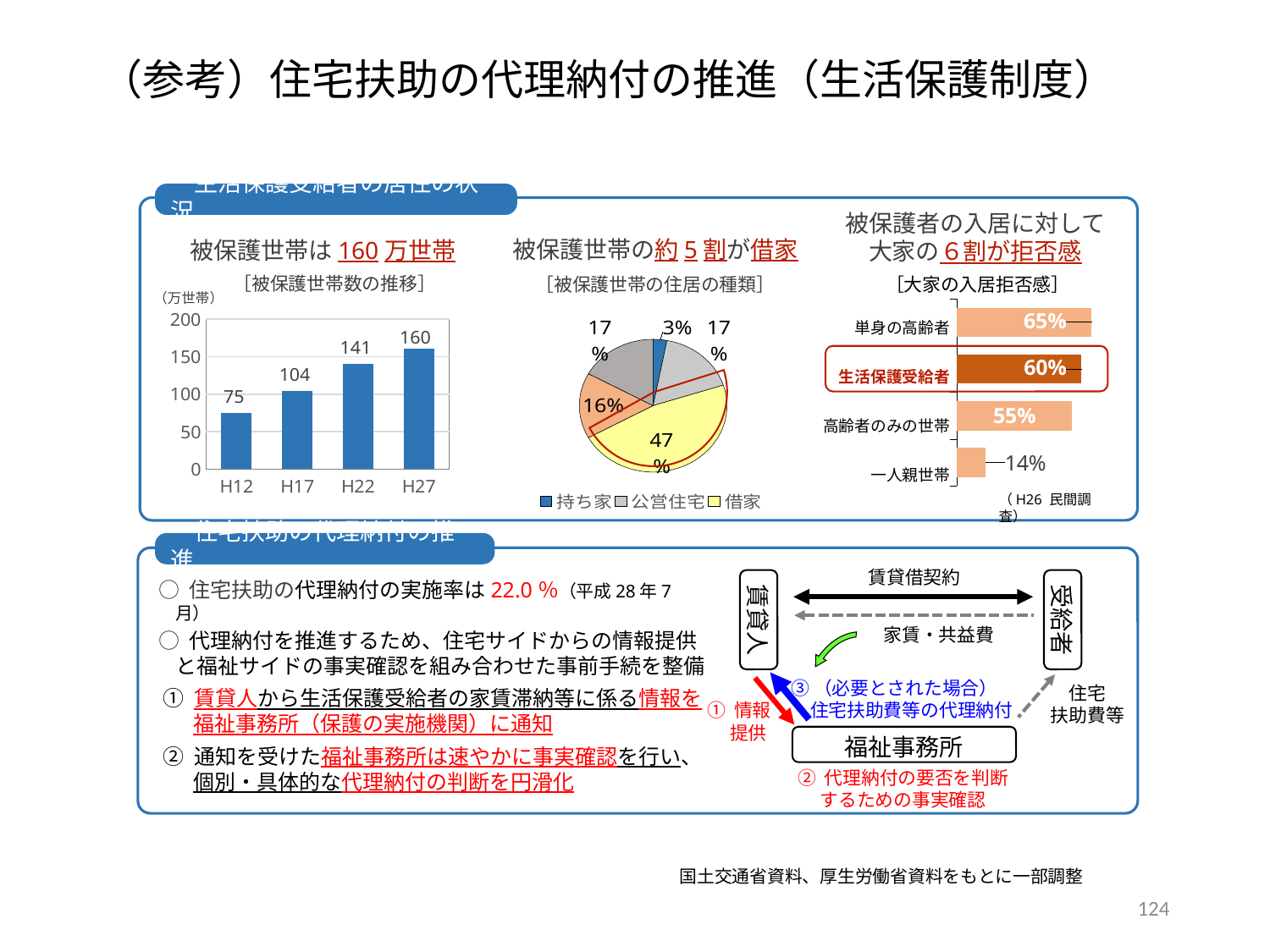
In the 被保護世帯の住居の種類 pie chart, what share is 持ち家? 3% In the 被保護世帯数の推移 chart, do the values rise or fall from H12 to H27? rise In the 大家の入居拒否感 chart, what is the value for 生活保護受給者? 60% How many entries does the legend of the 被保護世帯の住居の種類 pie chart list? 3 In the 大家の入居拒否感 chart, which category has the lowest value? 一人親世帯 In the 被保護世帯数の推移 chart, what is the difference between the H27 and H22 values? 19 In the 大家の入居拒否感 chart, what is the difference between 単身の高齢者 and 高齢者のみの世帯? 10% In the 被保護世帯数の推移 chart, what is the value for H12? 75 In the 被保護世帯数の推移 chart, how many categories are shown on the x axis? 4 In the 被保護世帯数の推移 chart, what is the value for H27? 160 In the 被保護世帯の住居の種類 pie chart, what share is 借家? 47% What kind of chart is the 被保護世帯数の推移 chart? bar chart